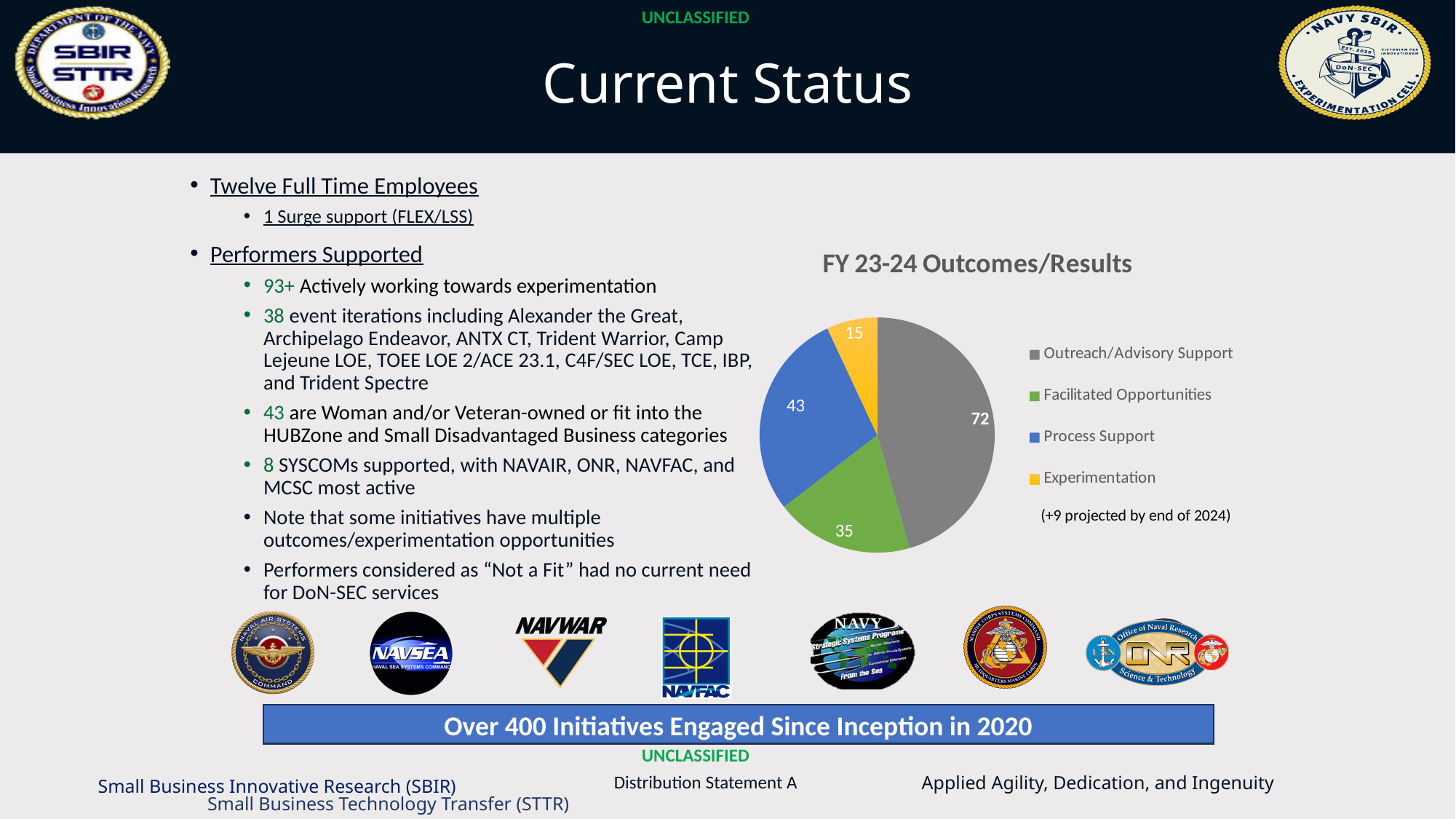
What colour represents Experimentation in the FY 23-24 Outcomes/Results pie chart? Yellow In the FY 23-24 Outcomes/Results pie chart, what is the difference between Outreach/Advisory Support and Process Support? 29 In the FY 23-24 Outcomes/Results pie chart, which is larger: Process Support or Facilitated Opportunities? Process Support What is the value for Outreach/Advisory Support in the FY 23-24 Outcomes/Results pie chart? 72 Which category has the smallest slice in the FY 23-24 Outcomes/Results pie chart? Experimentation What is the total of all slices in the FY 23-24 Outcomes/Results pie chart? 165 What is the value for Experimentation in the FY 23-24 Outcomes/Results pie chart? 15 Which category has the largest slice in the FY 23-24 Outcomes/Results pie chart? Outreach/Advisory Support What is the value for Process Support in the FY 23-24 Outcomes/Results pie chart? 43 What is the value for Facilitated Opportunities in the FY 23-24 Outcomes/Results pie chart? 35 What type of chart is shown under the title "FY 23-24 Outcomes/Results"? Pie chart How many categories does the legend of the FY 23-24 Outcomes/Results pie chart list? 4